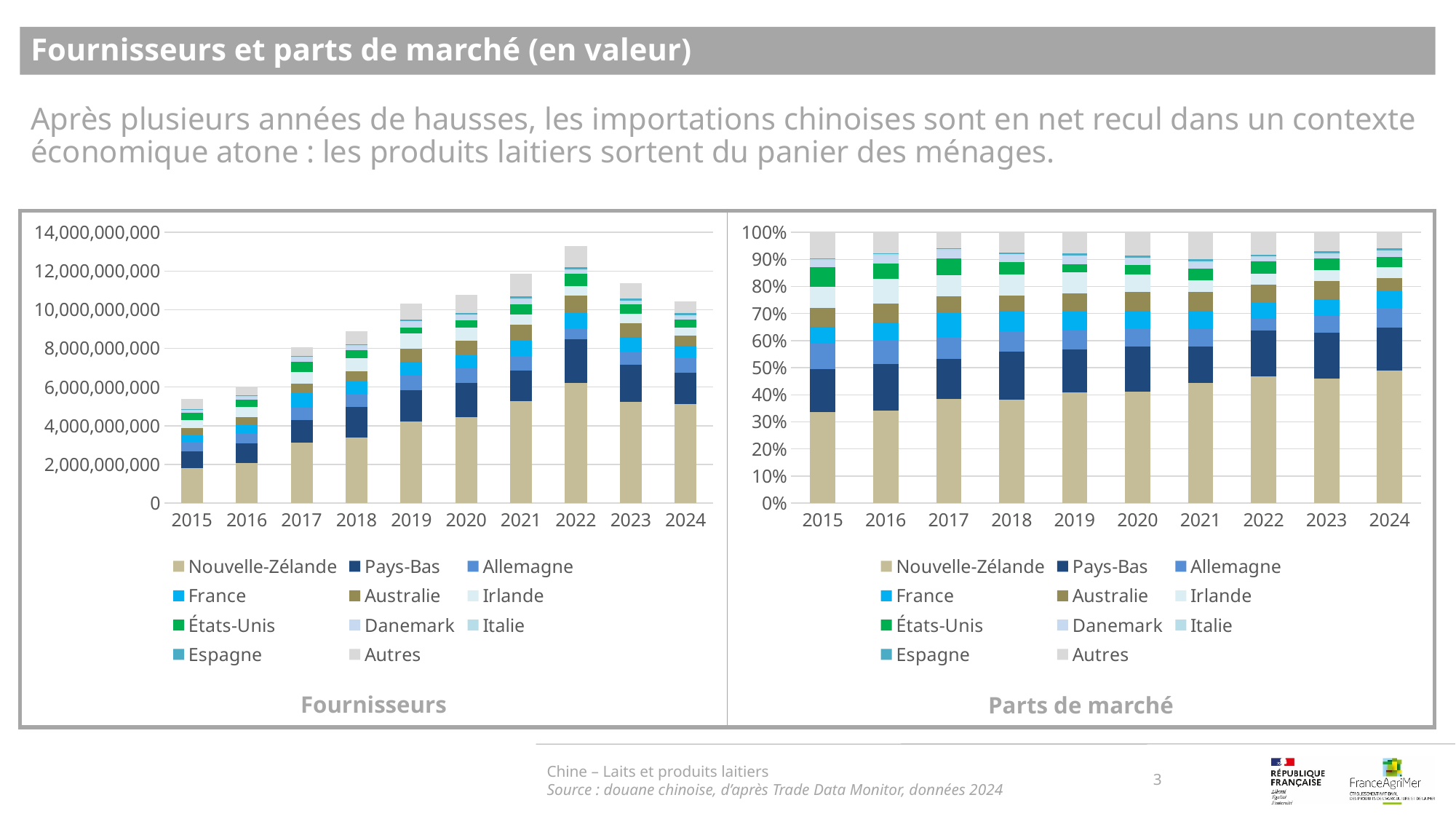
In the 'Parts de marché' chart, is the share of Nouvelle-Zélande in 2024 greater or less than 40%? greater How many series does the legend of the 'Parts de marché' chart list? 11 In the 'Fournisseurs' chart, is the total bar for 2022 greater or less than 12,000,000,000? greater In the 'Fournisseurs' chart, do the total bars rise or fall from 2015 to 2022? rise In the 'Fournisseurs' chart, which total bar is larger, 2022 or 2023? 2022 In the 'Fournisseurs' chart, which year has the tallest total bar? 2022 What kind of chart is the 'Fournisseurs' chart on the left? Stacked bar chart In the 'Parts de marché' chart, does the share of Nouvelle-Zélande rise or fall from 2015 to 2024? rise How many years are shown on the x axis of the 'Fournisseurs' chart? 10 In the 'Fournisseurs' chart, is the total bar for 2015 greater or less than 6,000,000,000? less In the 'Fournisseurs' chart, which year has the shortest total bar? 2015 Which series is plotted at the bottom of each stacked bar in the 'Parts de marché' chart? Nouvelle-Zélande